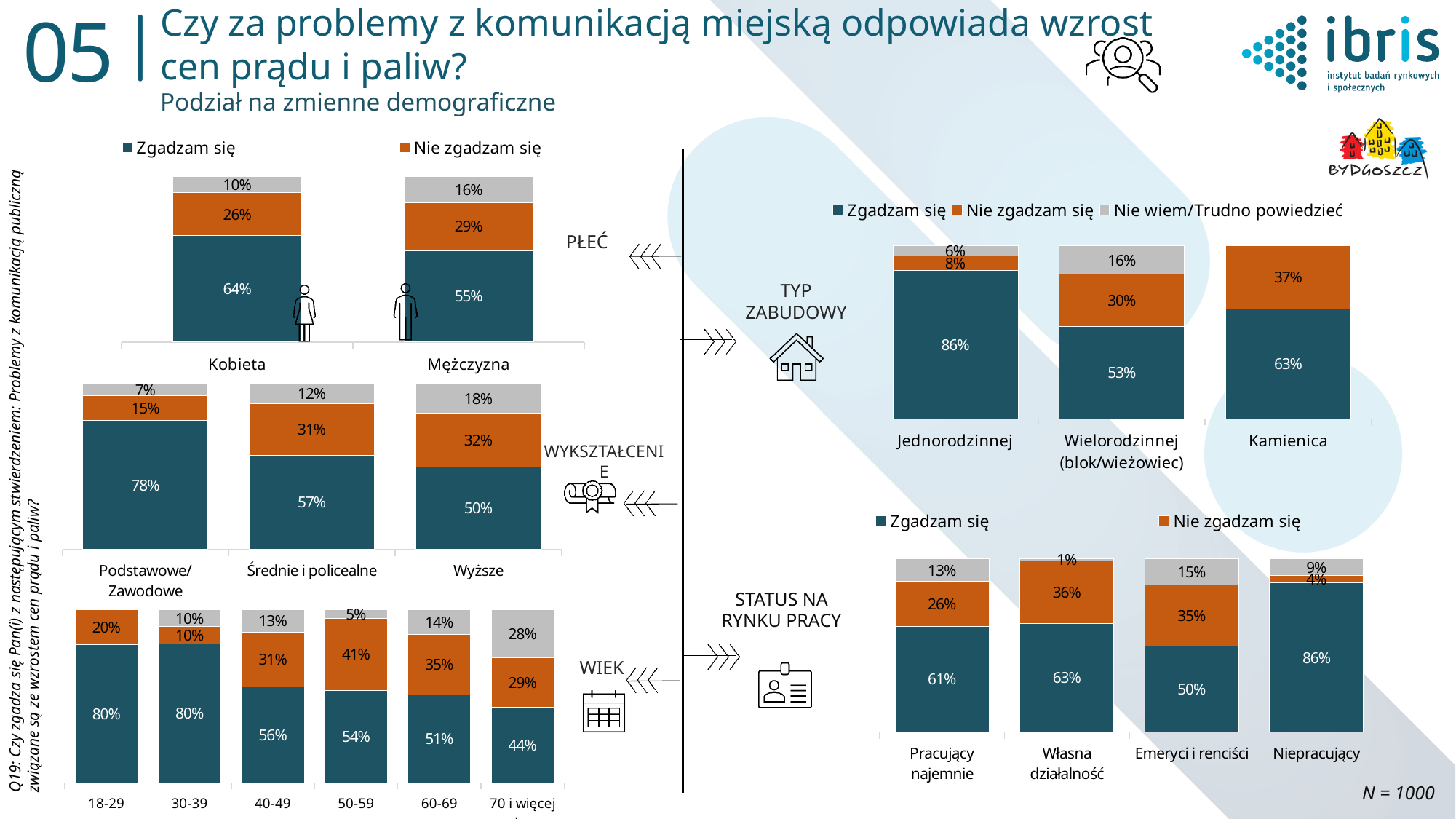
What type of chart is used for the TYP ZABUDOWY data? Stacked bar chart In the STATUS NA RYNKU PRACY chart, which has the larger Nie zgadzam się share: Własna działalność or Emeryci i renciści? Własna działalność How many age groups are shown in the WIEK chart? 6 In the WIEK chart, does the Zgadzam się share rise or fall as the age groups get older? Falls In the WIEK chart, which age group has the lowest Zgadzam się share? 70 i więcej How many series does the legend of the TYP ZABUDOWY chart list? 3 In the PŁEĆ chart, what percentage of Kobieta respondents answered Zgadzam się? 64% In the WYKSZTAŁCENIE chart, which education group has the highest Zgadzam się share? Podstawowe/Zawodowe In the TYP ZABUDOWY chart, what is the Nie zgadzam się value for Kamienica? 37% In the STATUS NA RYNKU PRACY chart, what is the Zgadzam się value for Niepracujący? 86% In the WYKSZTAŁCENIE chart, what is the total of the three segments for Wyższe? 100% In the PŁEĆ chart, by how many percentage points does the Zgadzam się share for Kobieta exceed that for Mężczyzna? 9 percentage points